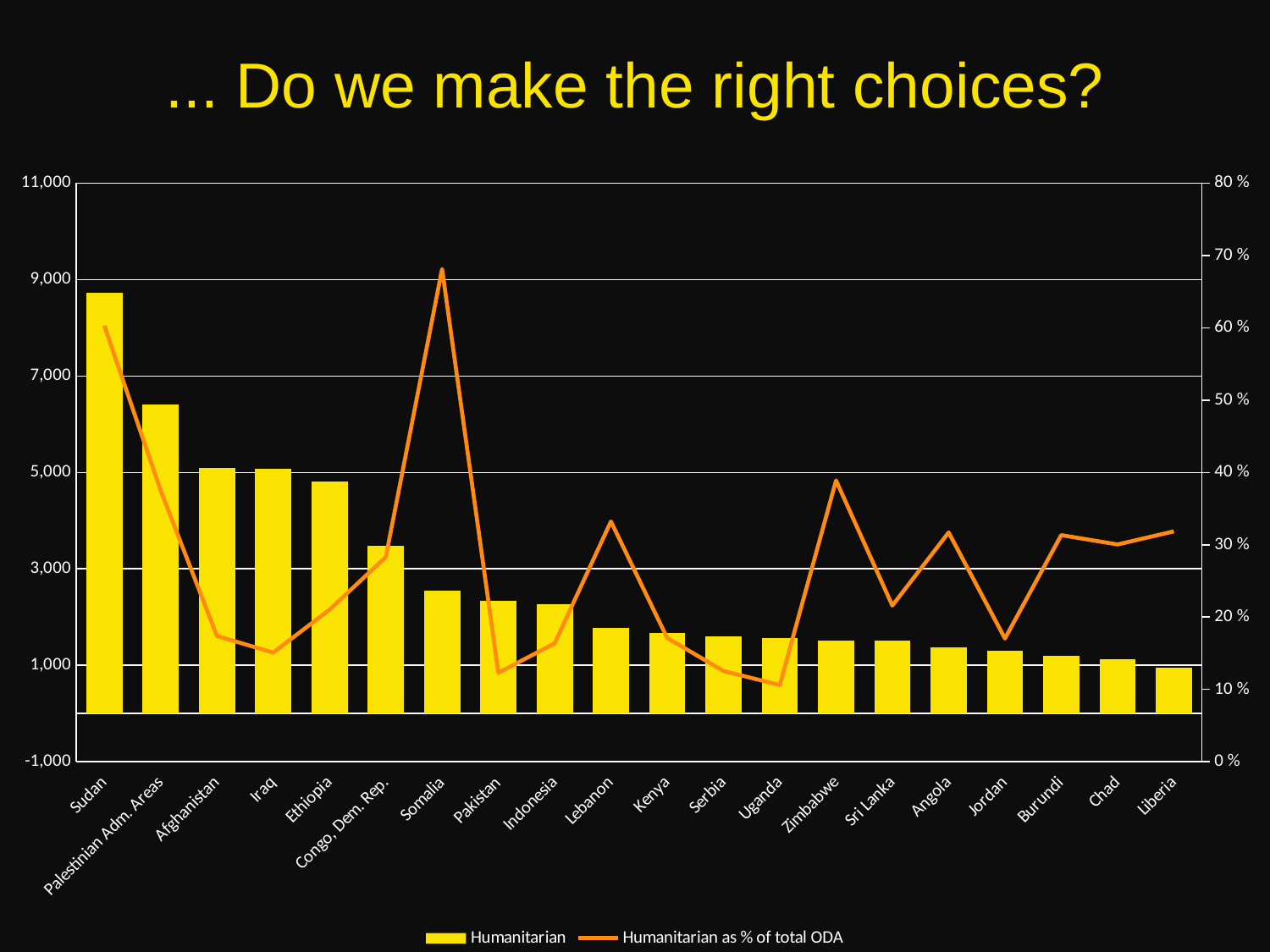
Is the 'Humanitarian as % of total ODA' value for Somalia greater or less than 60 %? greater Which country has the highest value on the 'Humanitarian as % of total ODA' line? Somalia How many series does the legend list? 2 Is the Humanitarian bar for Sudan greater or less than 7,000? greater Do the Humanitarian bars generally rise or fall from left to right along the x axis? fall Which has the larger Humanitarian bar, Sudan or Palestinian Adm. Areas? Sudan Is the 'Humanitarian as % of total ODA' value for Pakistan greater or less than 20 %? less Which country has the highest Humanitarian bar? Sudan How many countries or areas are shown on the x axis? 20 What kind of chart is shown on the slide? A bar chart combined with a line chart Which country has the lowest Humanitarian bar? Liberia